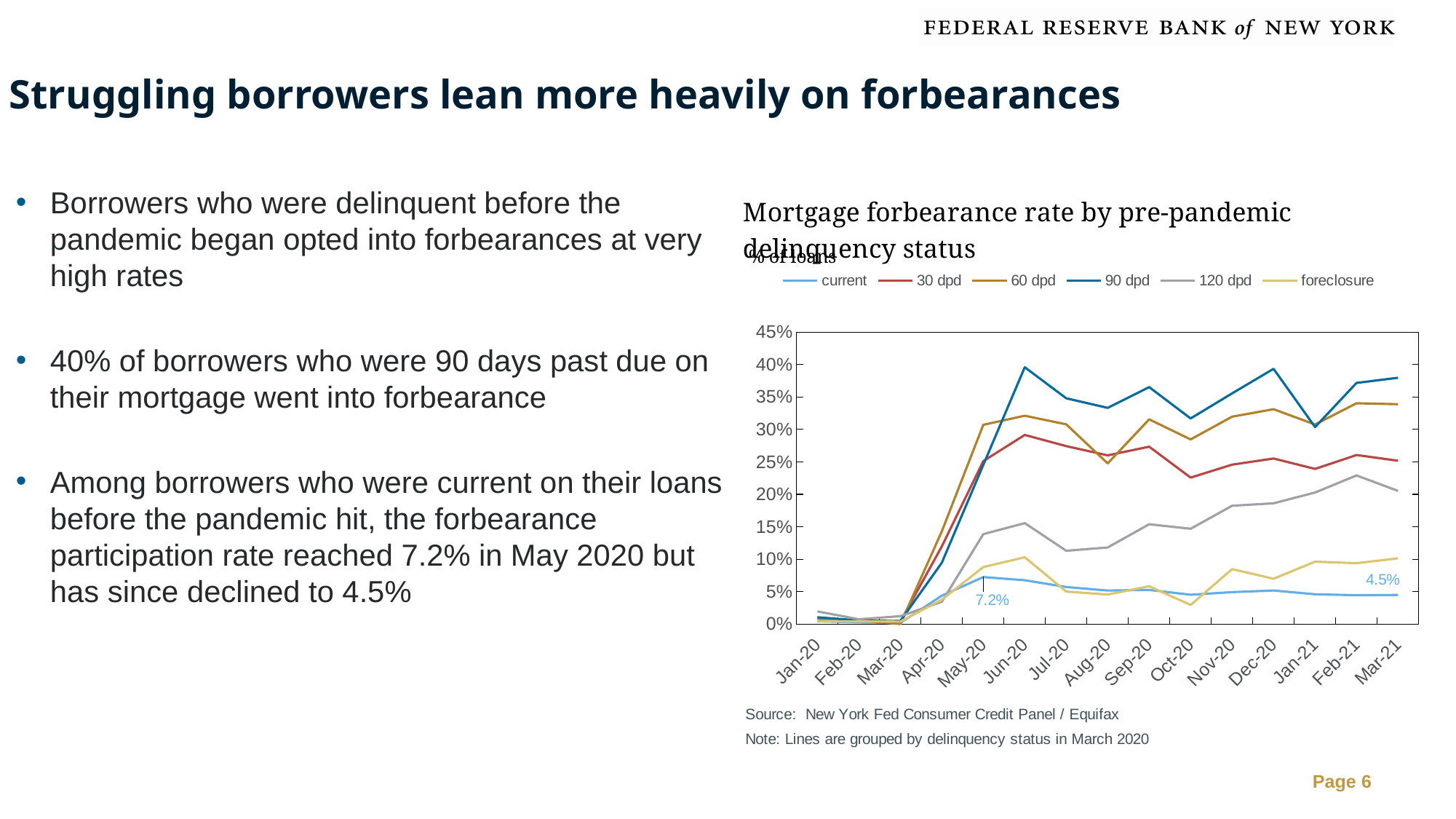
What is the forbearance rate for the 'current' series in May-20? 7.2% How many series does the chart legend list? 6 What is the forbearance rate for the 'current' series in Mar-21? 4.5% Which series has the lowest forbearance rate in Mar-21? current Is the value for the 90 dpd series in Jun-20 greater or less than 35%? greater What kind of chart is shown on the slide? Line chart Is the value for the 120 dpd series in Mar-21 greater or less than 25%? less Does the 'current' series rise or fall from May-20 to Mar-21? fall In Mar-21, which series is higher: 60 dpd or 30 dpd? 60 dpd Which series has the highest forbearance rate in Jun-20? 90 dpd By how much did the 'current' series fall from May-20 (7.2%) to Mar-21 (4.5%)? 2.7 percentage points How many months are shown on the x axis of the chart? 15